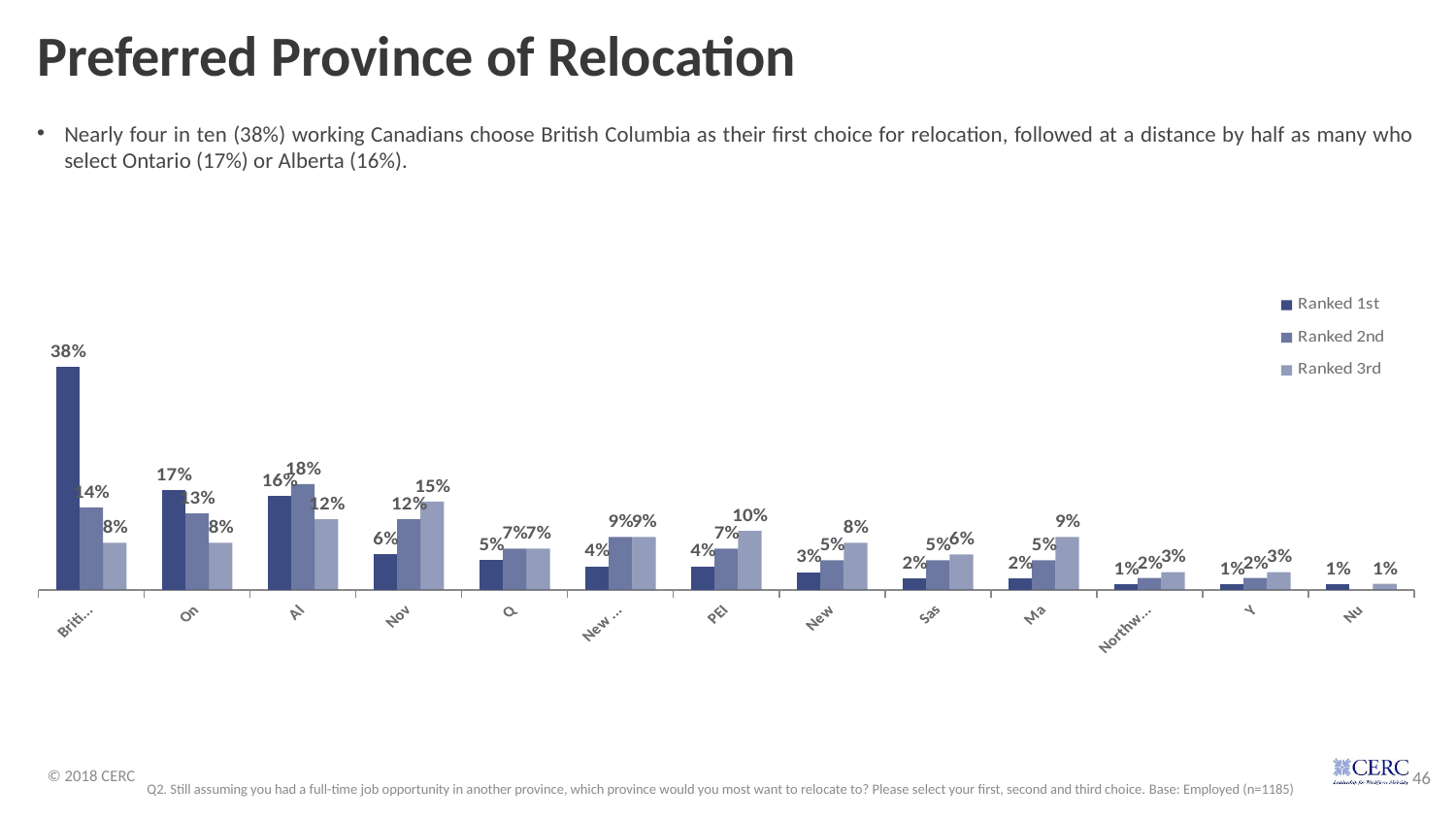
What are the three legend entries in the chart? Ranked 1st, Ranked 2nd, Ranked 3rd What is the Ranked 2nd value for Ontario? 13% What kind of chart is shown on the slide? Bar chart How many series does the legend list? 3 Do the Ranked 1st values generally rise or fall moving left to right along the x axis? Fall What percentage of working Canadians ranked British Columbia 1st as their preferred province of relocation? 38% Which has the larger Ranked 3rd value: PEI or Ontario? PEI What is the difference between the Ranked 1st values for British Columbia and Ontario? 21 percentage points How many provinces/territories are shown on the x axis of the chart? 13 What is the Ranked 3rd value for PEI? 10% For Alberta, which is larger: the Ranked 1st value or the Ranked 2nd value? Ranked 2nd Which province has the highest Ranked 1st value? British Columbia